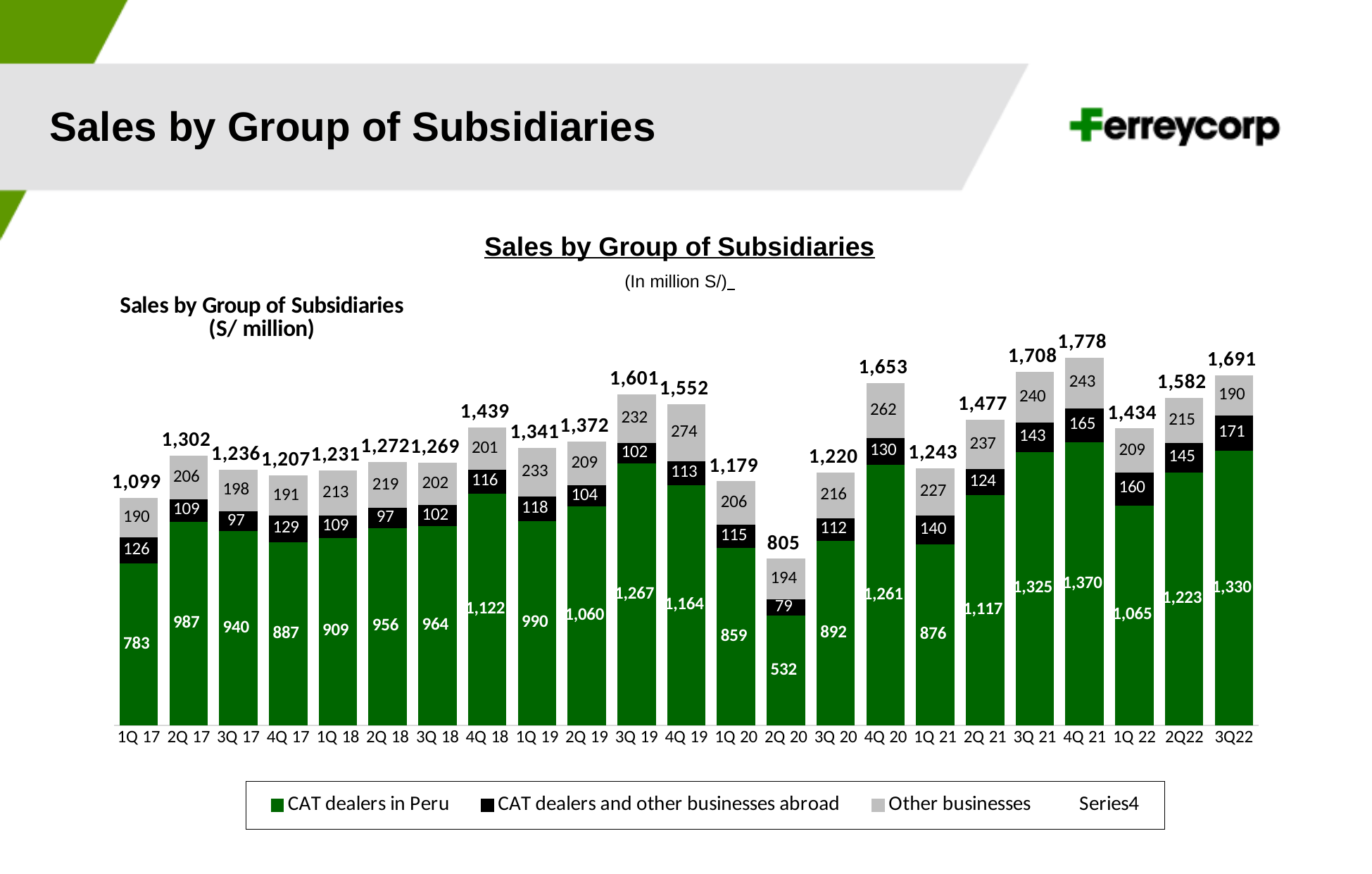
What is the difference between the total sales in 3Q22 and 2Q22? 109 Which is larger, the CAT dealers in Peru value in 3Q 21 or in 4Q 21? 4Q 21 What is the value for Other businesses in 4Q 19? 274 What is the total sales value shown for 4Q 21? 1,778 How many entries does the legend list? 4 What kind of chart is shown? Stacked bar chart Which quarter has the highest total sales? 4Q 21 What is the value for CAT dealers and other businesses abroad in 3Q22? 171 What is the value for CAT dealers in Peru in 2Q 20? 532 Which quarter has the lowest total sales? 2Q 20 How many quarters are shown on the x axis? 23 What colour represents CAT dealers in Peru? Green